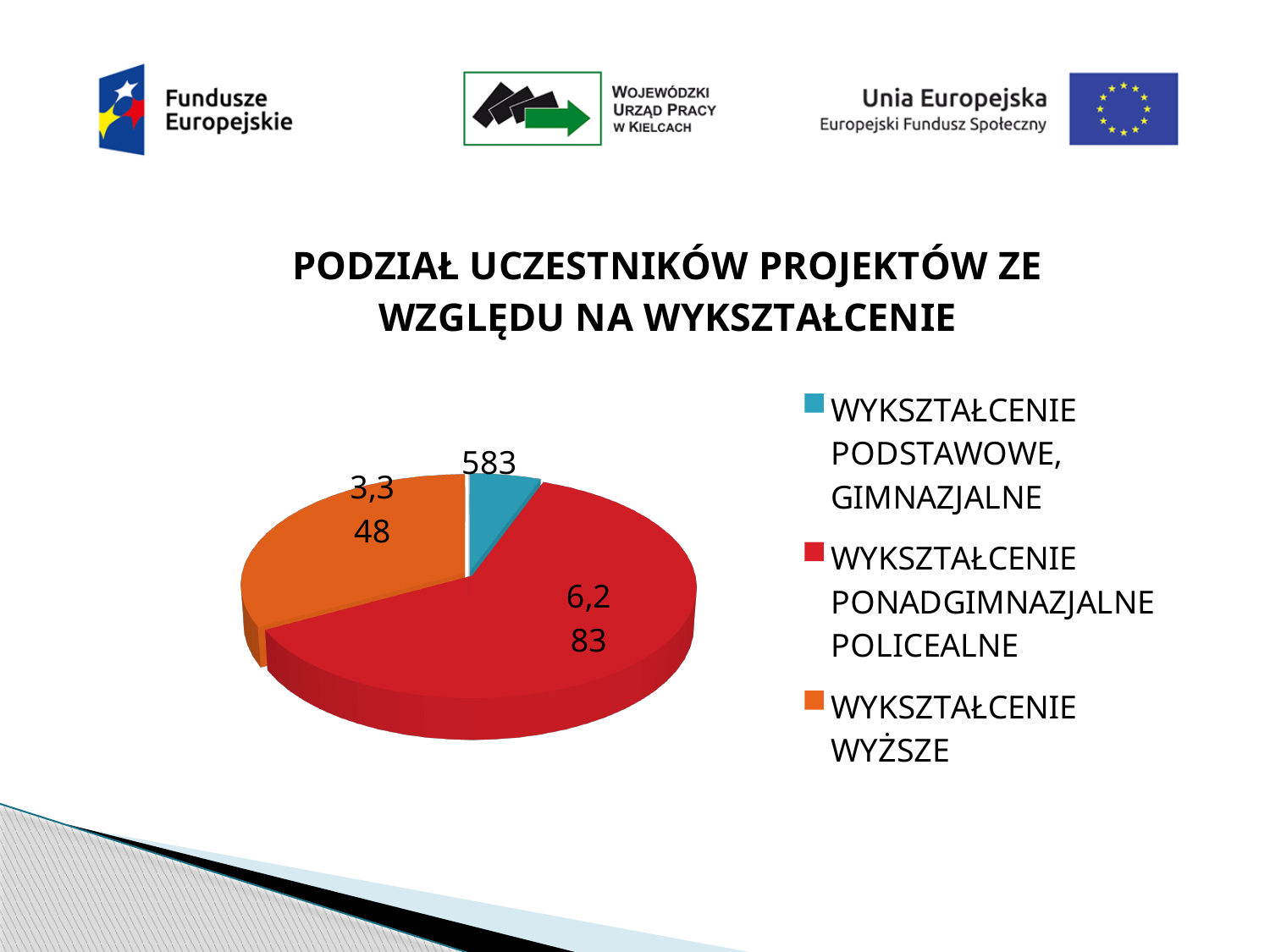
What colour is the slice for WYKSZTAŁCENIE WYŻSZE? orange Which slice is larger: WYKSZTAŁCENIE PONADGIMNAZJALNE POLICEALNE or WYKSZTAŁCENIE WYŻSZE? WYKSZTAŁCENIE PONADGIMNAZJALNE POLICEALNE What value is shown for the WYKSZTAŁCENIE PODSTAWOWE, GIMNAZJALNE slice? 583 How many slices does the pie chart have? 3 How many entries does the legend of the pie chart list? 3 Which slice is larger: WYKSZTAŁCENIE WYŻSZE or WYKSZTAŁCENIE PODSTAWOWE, GIMNAZJALNE? WYKSZTAŁCENIE WYŻSZE What type of chart is shown on the slide? pie chart Which education category has the smallest slice of the pie? WYKSZTAŁCENIE PODSTAWOWE, GIMNAZJALNE What is the title of the chart on the slide? PODZIAŁ UCZESTNIKÓW PROJEKTÓW ZE WZGLĘDU NA WYKSZTAŁCENIE Which education category has the largest slice of the pie? WYKSZTAŁCENIE PONADGIMNAZJALNE POLICEALNE